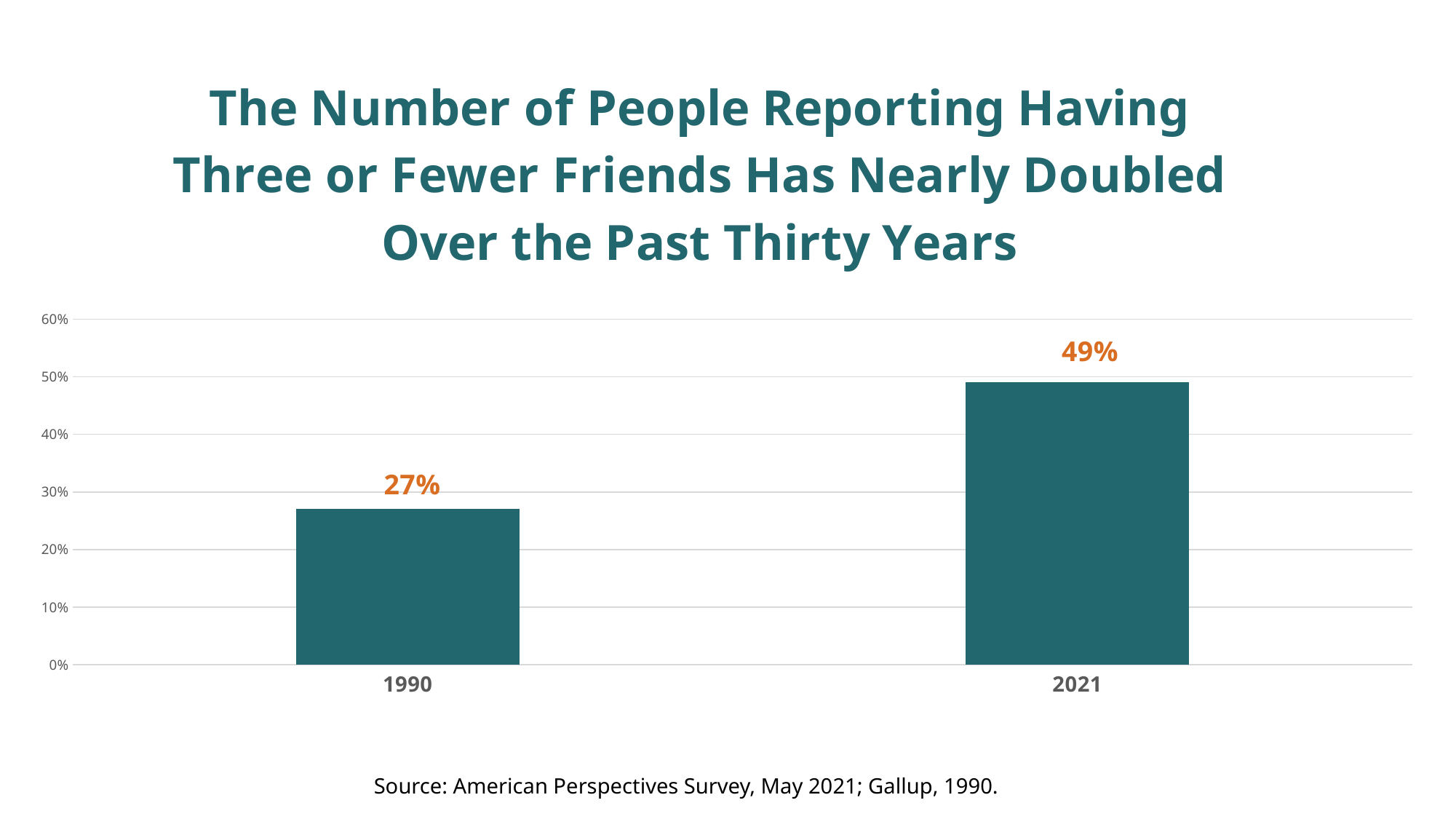
What is the difference between the values for 2021 and 1990? 22% What kind of chart is shown on the slide? bar chart What is the value for 1990? 27% Is the value for 1990 greater or less than 30%? less Which is larger, the value for 1990 or the value for 2021? 2021 What is the value for 2021? 49% Which year has the lowest value? 1990 Do the values rise or fall from 1990 to 2021? rise What is the highest value shown on the vertical axis? 60% Which year has the highest value? 2021 How many bars are shown in the chart? 2 Is the value for 2021 greater or less than 40%? greater